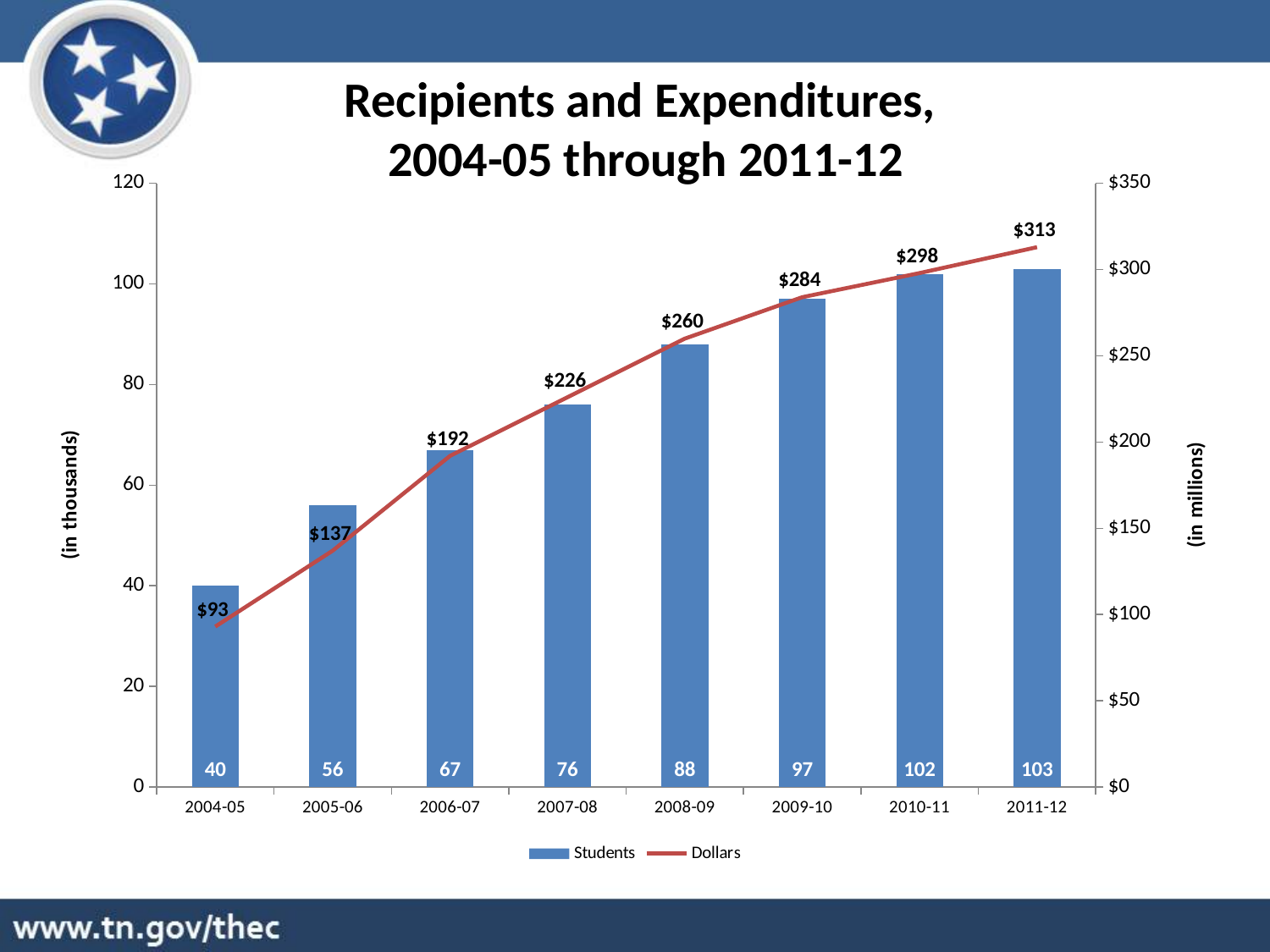
What is the Students value for 2008-09? 88 What is the Dollars value for 2006-07? $192 What is the difference between the Students values for 2007-08 and 2005-06? 20 Which year has the highest Dollars value? 2011-12 How many series does the legend list? 2 What is the difference between the Dollars values for 2011-12 and 2004-05? $220 Which is larger, the Students value for 2009-10 or for 2006-07? 2009-10 Which year has the lowest Students value? 2004-05 How many years are shown on the x axis? 8 What is the Students value for 2004-05? 40 Do the Dollars values rise or fall from 2004-05 to 2011-12? Rise What kind of chart is this? Combined bar and line chart